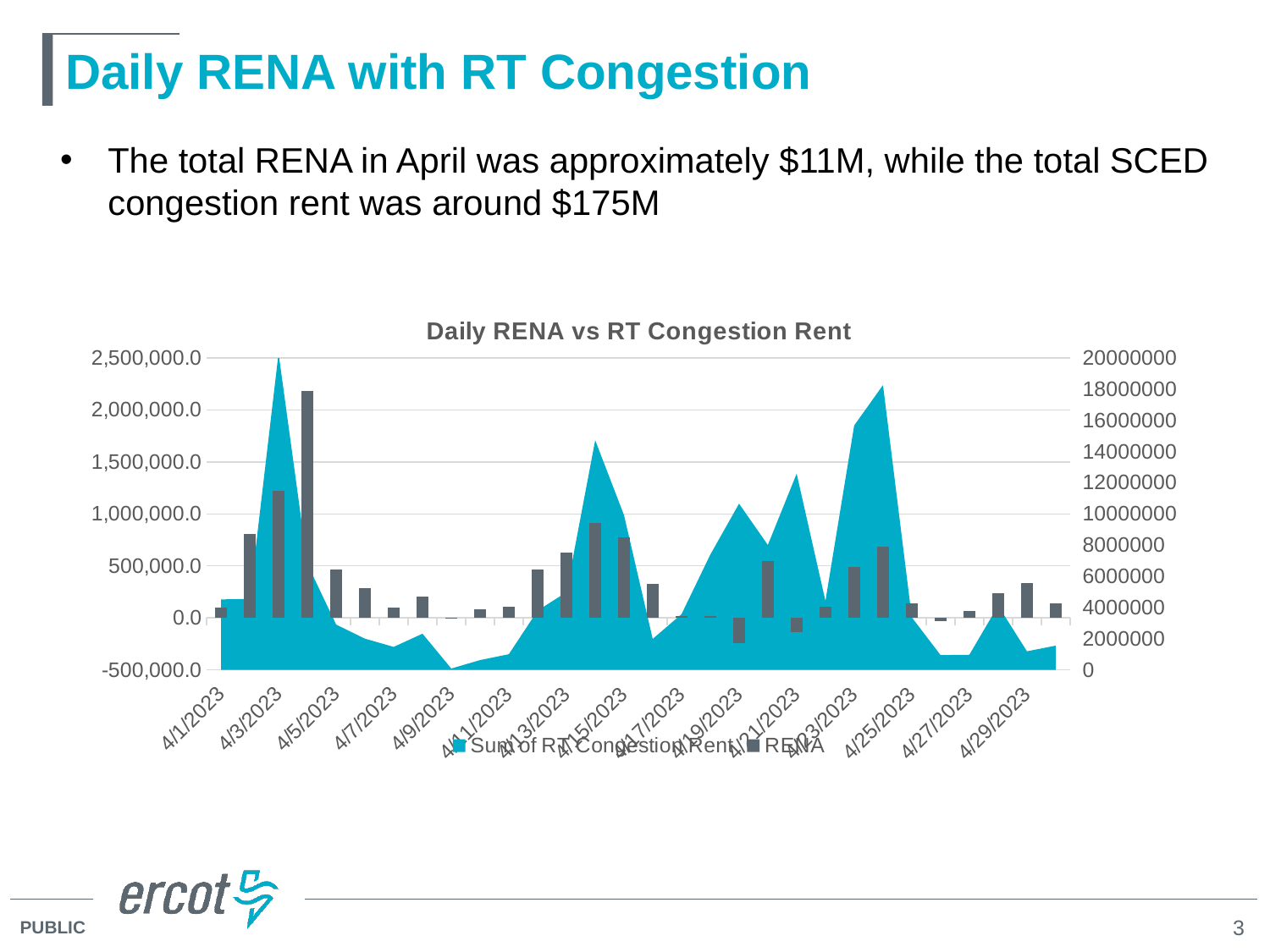
Do the RENA bars rise steadily, fall steadily, or fluctuate across April? fluctuate Is the RENA value on 4/3/2023 greater or less than 1,000,000.0? greater Which series is drawn as the shaded area rather than as bars? Sum of RT Congestion Rent Is the RENA value on 4/1/2023 greater or less than 500,000.0? less Which is larger, the RENA value on 4/3/2023 or on 4/5/2023? 4/3/2023 How many series does the chart legend list? 2 What is the highest value shown on the left y axis? 2,500,000.0 How many date labels are shown along the x axis? 15 What kind of chart is shown on the slide? A combined area and bar chart Is the tallest RENA bar greater or less than 2,000,000.0? greater What is the title of the chart? Daily RENA vs RT Congestion Rent